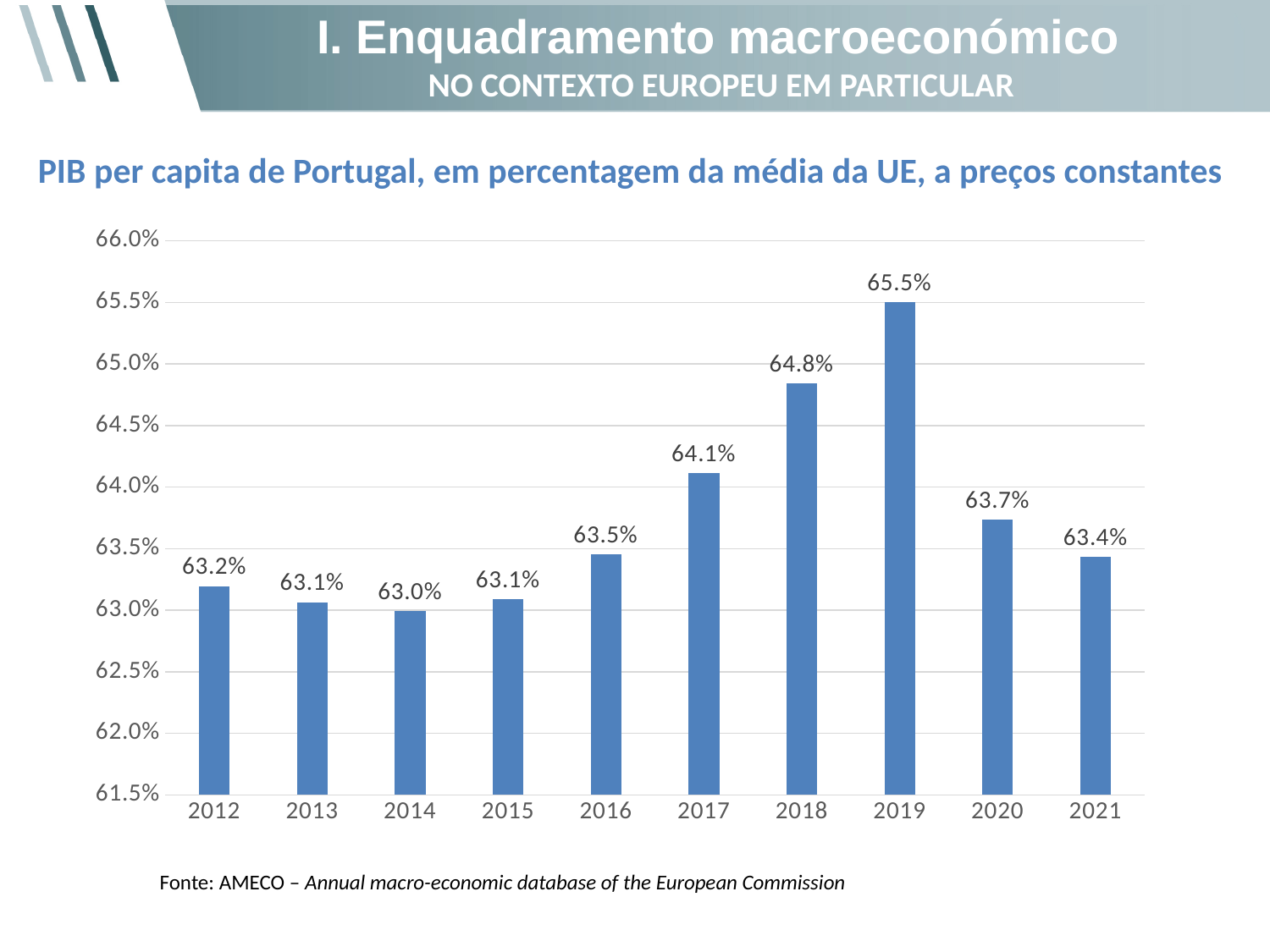
What is the value for 2012? 63.2% Which is larger, the value for 2017 or the value for 2020? 2017 What is the difference between the values for 2019 and 2018? 0.7% How many years are shown on the x axis? 10 Is the value for 2018 greater or less than 64.5%? greater What kind of chart is shown on the slide? Bar chart Do the values rise or fall from 2016 to 2019? Rise What is the value for 2019? 65.5% What is the source cited below the chart? AMECO – Annual macro-economic database of the European Commission Which year has the highest value? 2019 What is the value for 2021? 63.4% Which year has the lowest value? 2014